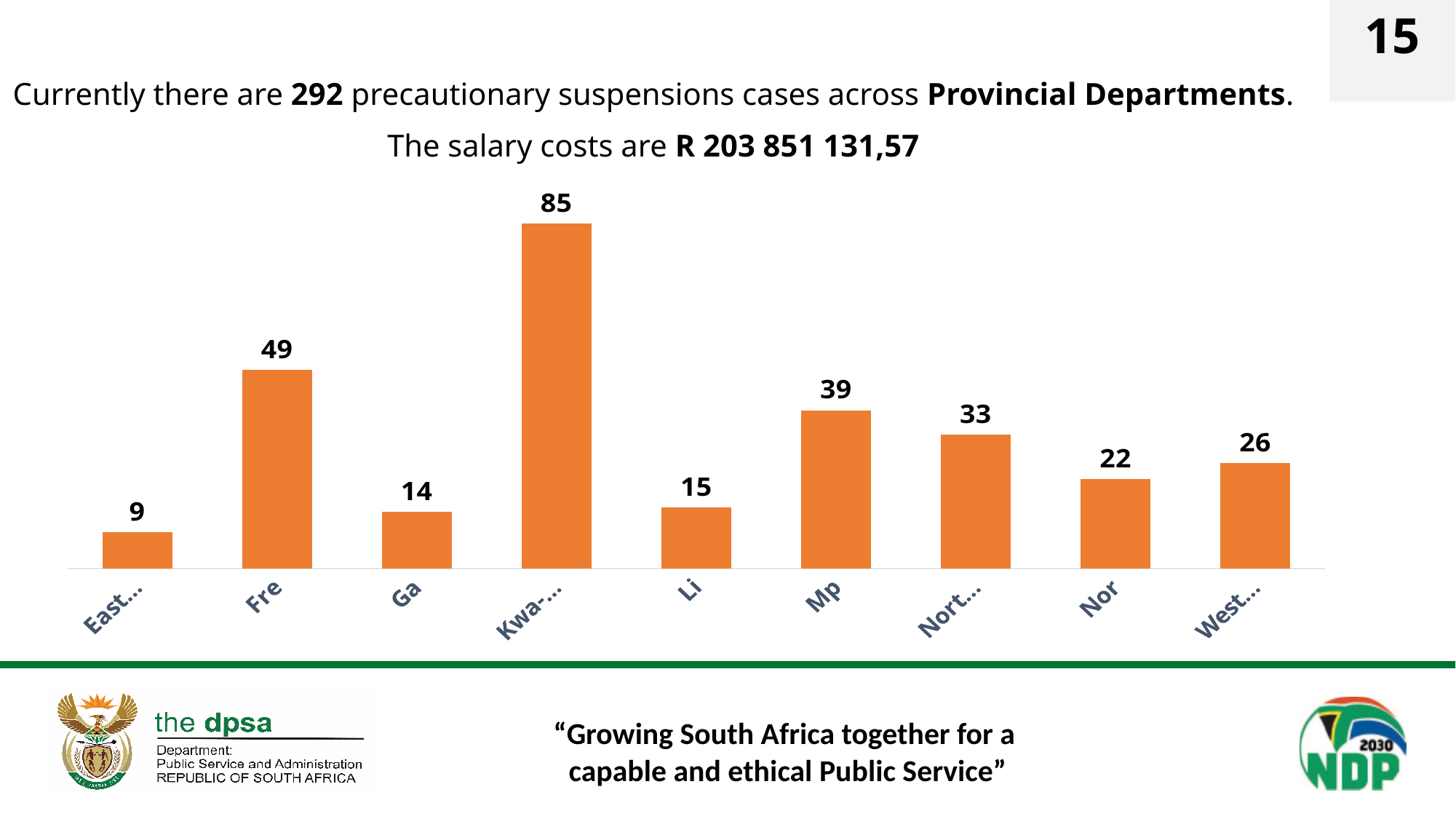
What is the difference between the values for "Mp" and "Nort..."? 6 What is the difference between the values for "Kwa-..." and "Fre"? 36 What kind of chart is shown on the slide? Bar chart Which category has the highest value? Kwa-... Which is larger, the value for "Nor" or the value for "West..."? West... Which is larger, the value for "Ga" or the value for "Li"? Li What colour are the bars in the chart? Orange What is the value for the bar labelled "Mp"? 39 How many categories are shown on the x axis? 9 What is the value for the bar labelled "Fre"? 49 What is the value for the bar labelled "Li"? 15 Which category has the lowest value? East...